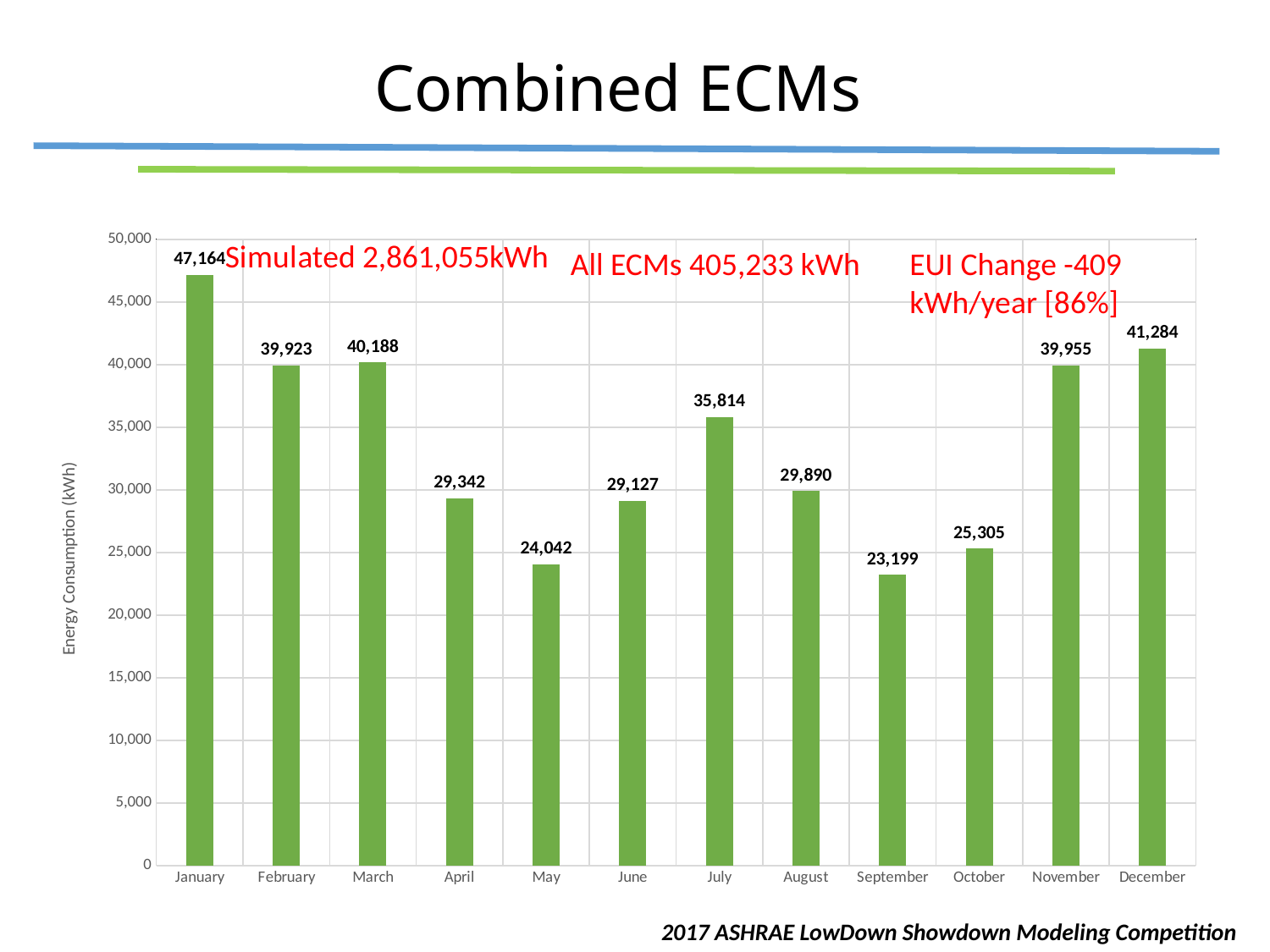
What kind of chart is shown on the slide? bar chart Which is larger, the value for July or the value for August? July Which month has the highest energy consumption? January What is the difference between the January and September values? 23,965 What is the energy consumption value for July? 35,814 What is the energy consumption value for January? 47,164 What is the difference between the December and November values? 1,329 What is the label on the vertical axis? Energy Consumption (kWh) Is the value for May greater or less than 25,000? less What is the energy consumption value for September? 23,199 How many months are shown on the x axis? 12 Which month has the lowest energy consumption? September